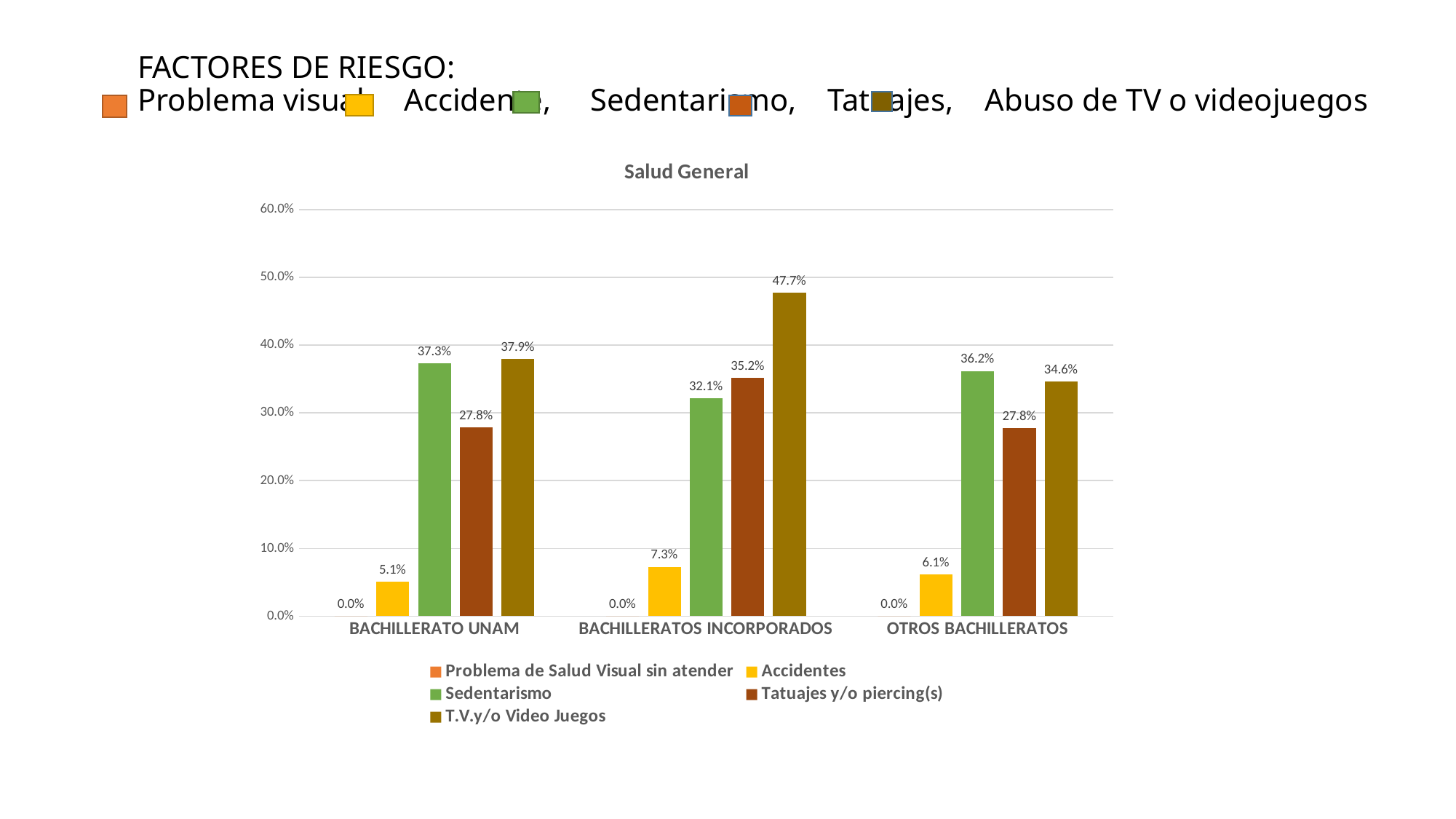
What is the difference between the T.V.y/o Video Juegos values for BACHILLERATOS INCORPORADOS and OTROS BACHILLERATOS? 13.1% What is the value for Sedentarismo in the BACHILLERATO UNAM group? 37.3% What is the value for Accidentes in the OTROS BACHILLERATOS group? 6.1% How many groups are shown on the x axis? 3 What is the value for Tatuajes y/o piercing(s) in the BACHILLERATOS INCORPORADOS group? 35.2% What kind of chart is shown? Bar chart Which is larger: Sedentarismo for BACHILLERATO UNAM or Sedentarismo for BACHILLERATOS INCORPORADOS? BACHILLERATO UNAM What is the title of the chart? Salud General Which group has the highest value for T.V.y/o Video Juegos? BACHILLERATOS INCORPORADOS How many series does the legend list? 5 Which group has the lowest value for Accidentes? BACHILLERATO UNAM What is the value for T.V.y/o Video Juegos in the BACHILLERATOS INCORPORADOS group? 47.7%